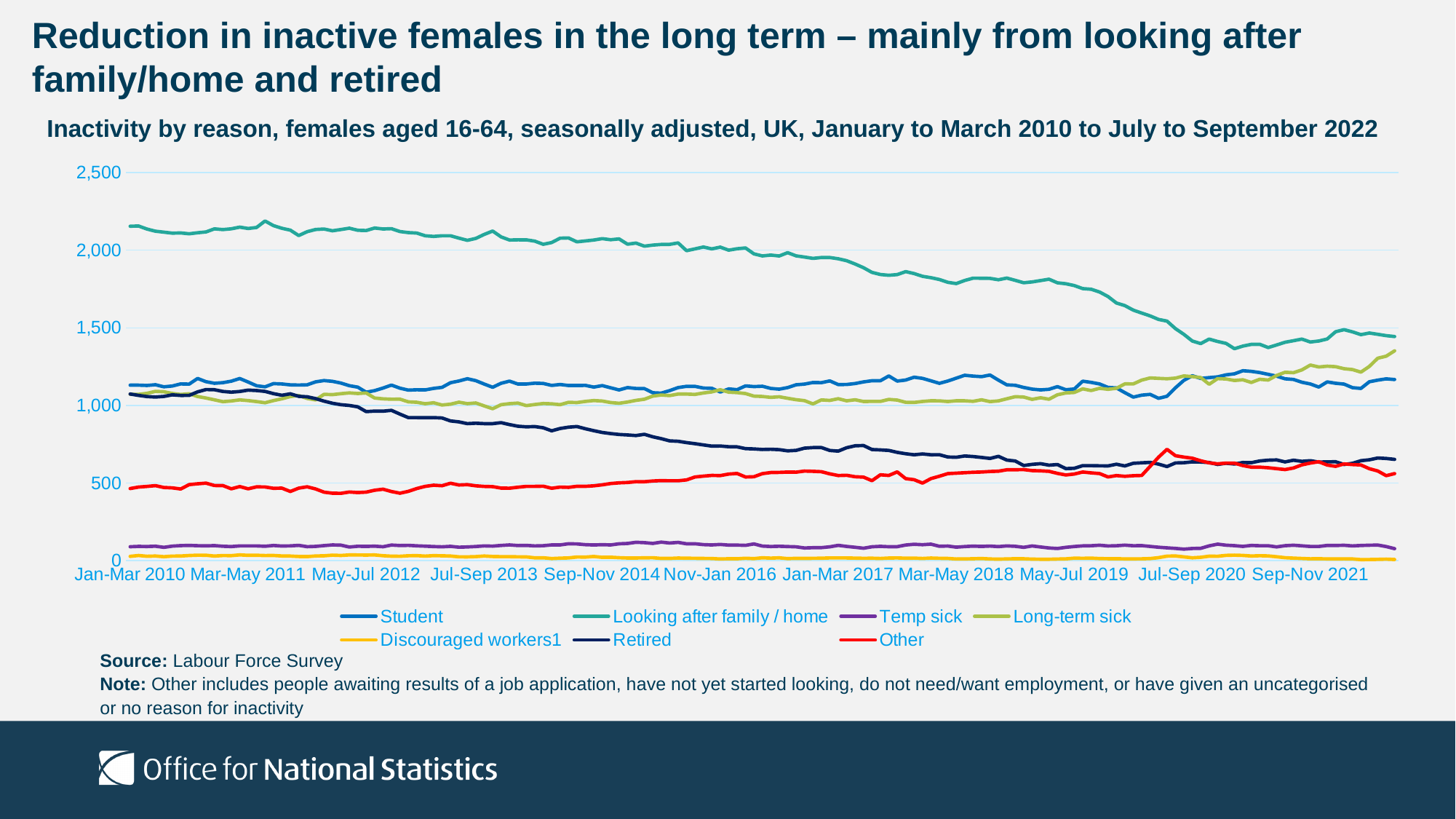
Is the value for Retired at Jan-Mar 2010 greater or less than 1,000? greater Does the Retired series rise or fall from Jan-Mar 2010 to the end of the period? fall Which series has the highest values across the whole period? Looking after family / home Is the value for Looking after family / home at Jan-Mar 2010 greater or less than 2,000? greater At Sep-Nov 2021, which is larger, the Student series or the Retired series? Student What kind of chart is shown on the slide? line chart How many series does the legend list? 7 Which series has the lowest values across the whole period? Discouraged workers1 Does the Looking after family / home series rise or fall from Jan-Mar 2010 to the end of the period? fall Does the Long-term sick series rise or fall over the period shown? rise What is the source of the data shown in the chart? Labour Force Survey Is the value for Other at Jan-Mar 2010 greater or less than 500? less